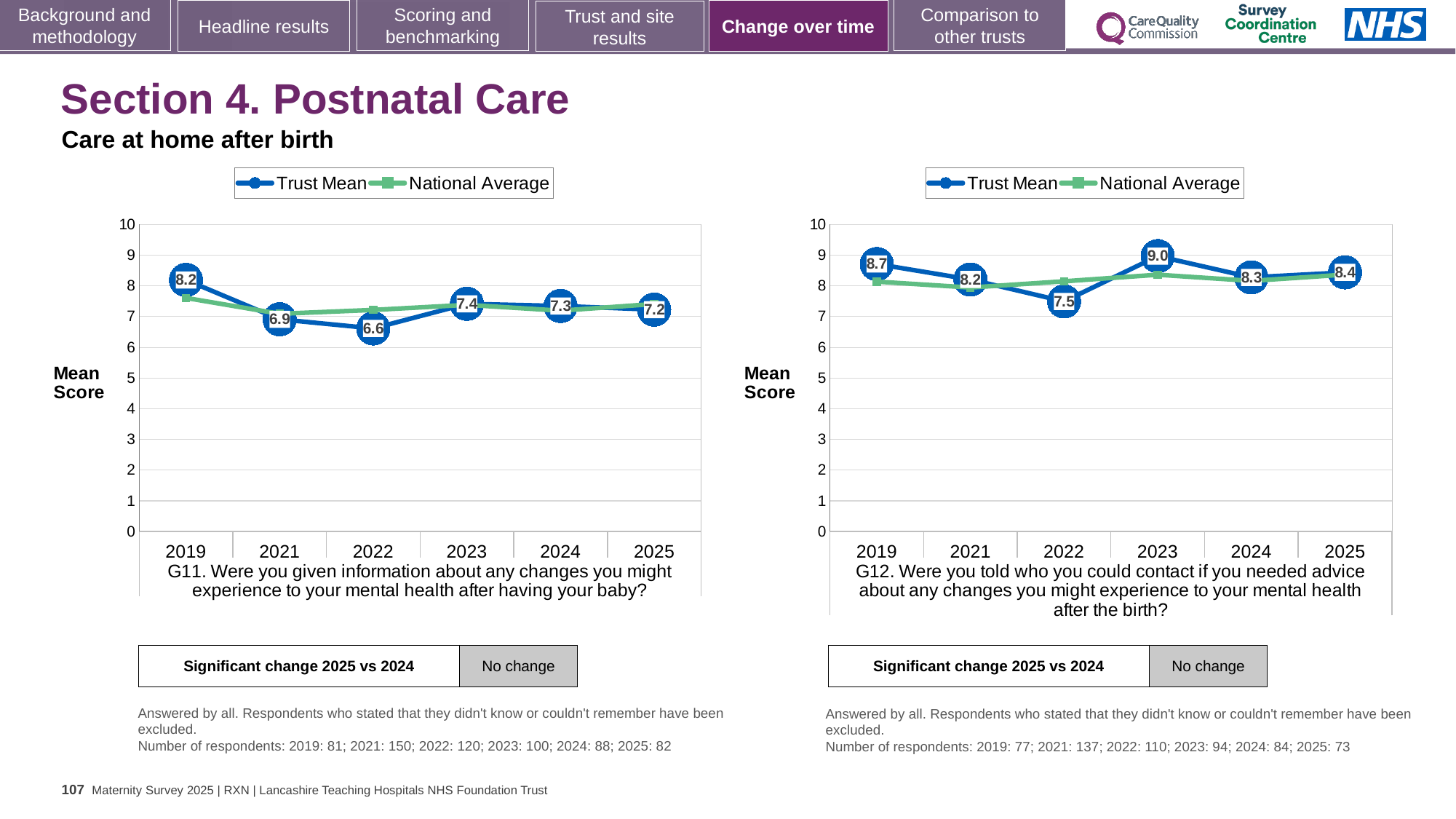
In the G11 chart (left), what is the Trust Mean score for 2022? 6.6 How many series does the legend of the G12 chart (right) list? 2 What type of chart is the G11 chart (left)? Line chart In the G11 chart (left), which year has the lowest Trust Mean score? 2022 In the G12 chart (right), what is the difference between the Trust Mean scores for 2023 and 2022? 1.5 In the G12 chart (right), which year has the lowest Trust Mean score? 2022 In the G11 chart (left), what is the difference between the Trust Mean scores for 2019 and 2025? 1.0 In the G11 chart (left), what is the Trust Mean score for 2019? 8.2 How many years are plotted on the x axis of the G11 chart (left)? 6 In the G12 chart (right), what is the Trust Mean score for 2023? 9.0 In the G12 chart (right), which year has the highest Trust Mean score? 2023 In the G12 chart (right), is the Trust Mean score for 2022 greater or less than the score for 2021? less